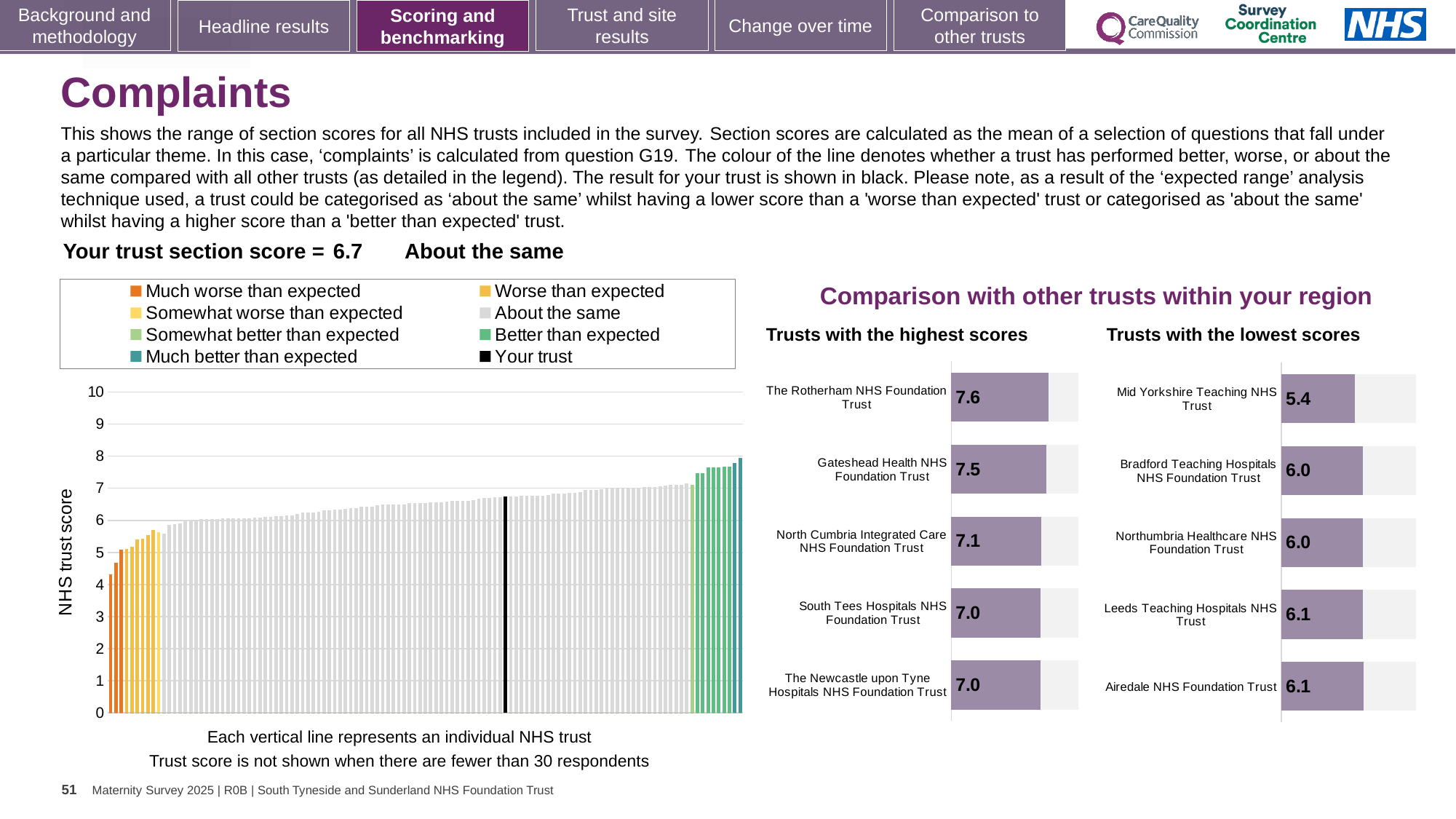
On the 'Trusts with the lowest scores' chart, what is the score for Mid Yorkshire Teaching NHS Trust? 5.4 On the 'Trusts with the highest scores' chart, which trust has the highest score? The Rotherham NHS Foundation Trust On the main NHS trust score chart, what is the section score for your trust (the black bar)? 6.7 On the 'Trusts with the lowest scores' chart, which has the higher score: Bradford Teaching Hospitals NHS Foundation Trust or Leeds Teaching Hospitals NHS Trust? Leeds Teaching Hospitals NHS Trust On the 'Trusts with the lowest scores' chart, which trust has the lowest score? Mid Yorkshire Teaching NHS Trust How many entries does the legend of the main NHS trust score chart list? 8 On the 'Trusts with the lowest scores' chart, what is the difference between the scores of Airedale NHS Foundation Trust and Mid Yorkshire Teaching NHS Trust? 0.7 On the 'Trusts with the highest scores' chart, what is the difference between the scores of The Rotherham NHS Foundation Trust and The Newcastle upon Tyne Hospitals NHS Foundation Trust? 0.6 On the 'Trusts with the highest scores' chart, what is the score for The Rotherham NHS Foundation Trust? 7.6 On the 'Trusts with the highest scores' chart, what is the score for North Cumbria Integrated Care NHS Foundation Trust? 7.1 On the main NHS trust score chart, is the value of the lowest bar greater or less than 5? less How many trusts are shown on the 'Trusts with the highest scores' chart? 5